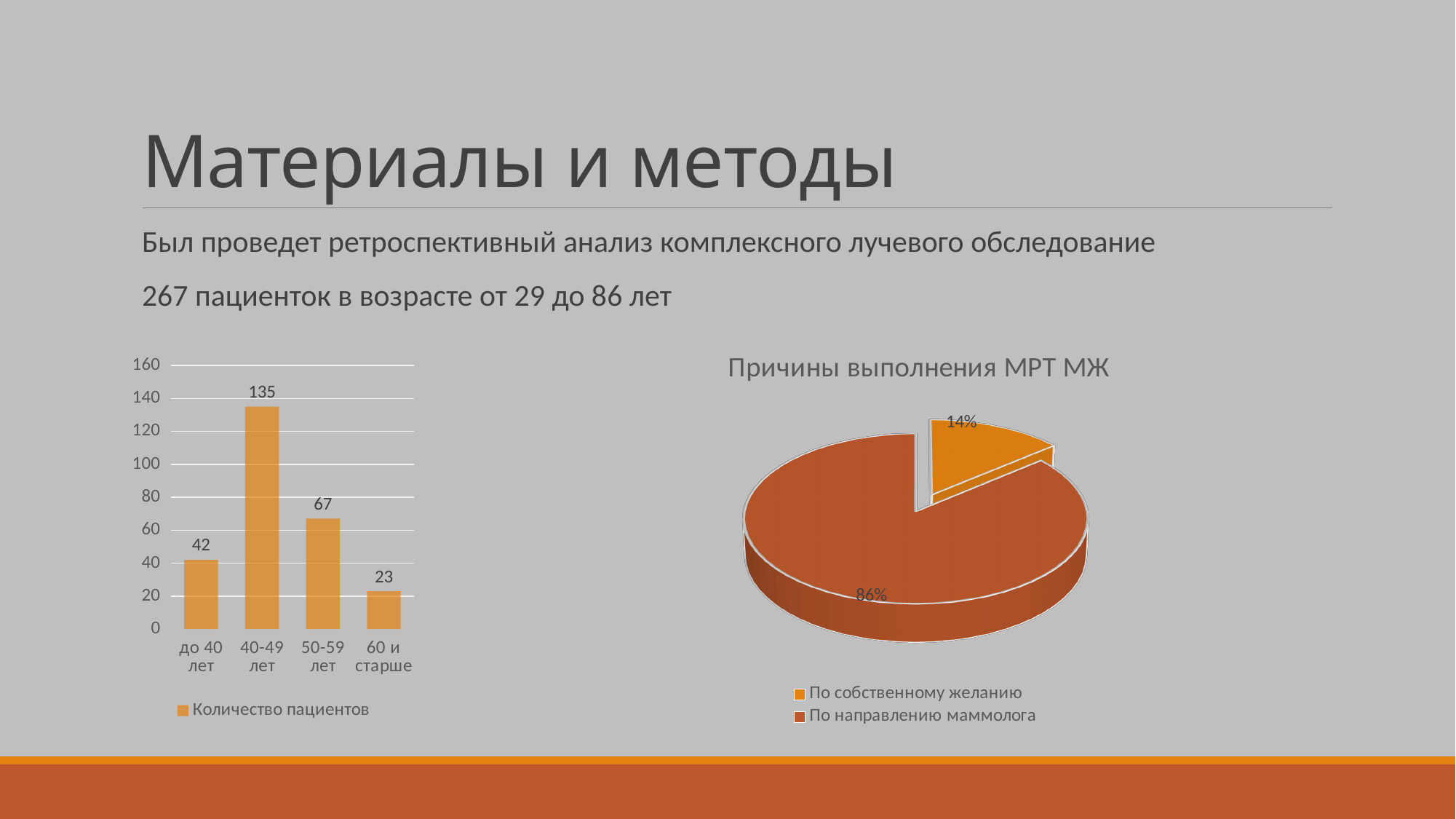
In the bar chart on the left, what is the value for the 60 и старше category? 23 In the pie chart titled 'Причины выполнения МРТ МЖ', what share is labelled 'По собственному желанию'? 14% What is the legend entry of the bar chart on the left? Количество пациентов In the bar chart on the left, what is the value for the 40-49 лет category? 135 In the bar chart on the left, which age category has the highest number of patients? 40-49 лет In the bar chart on the left, how many age categories are shown? 4 In the bar chart on the left, what is the difference between the values for 40-49 лет and 50-59 лет? 68 In the bar chart on the left, which is larger: the value for до 40 лет or the value for 50-59 лет? 50-59 лет In the pie chart titled 'Причины выполнения МРТ МЖ', what share is labelled 'По направлению маммолога'? 86% How many entries does the legend of the pie chart on the right list? 2 What type of chart is the chart on the left? bar chart In the bar chart on the left, which age category has the lowest number of patients? 60 и старше